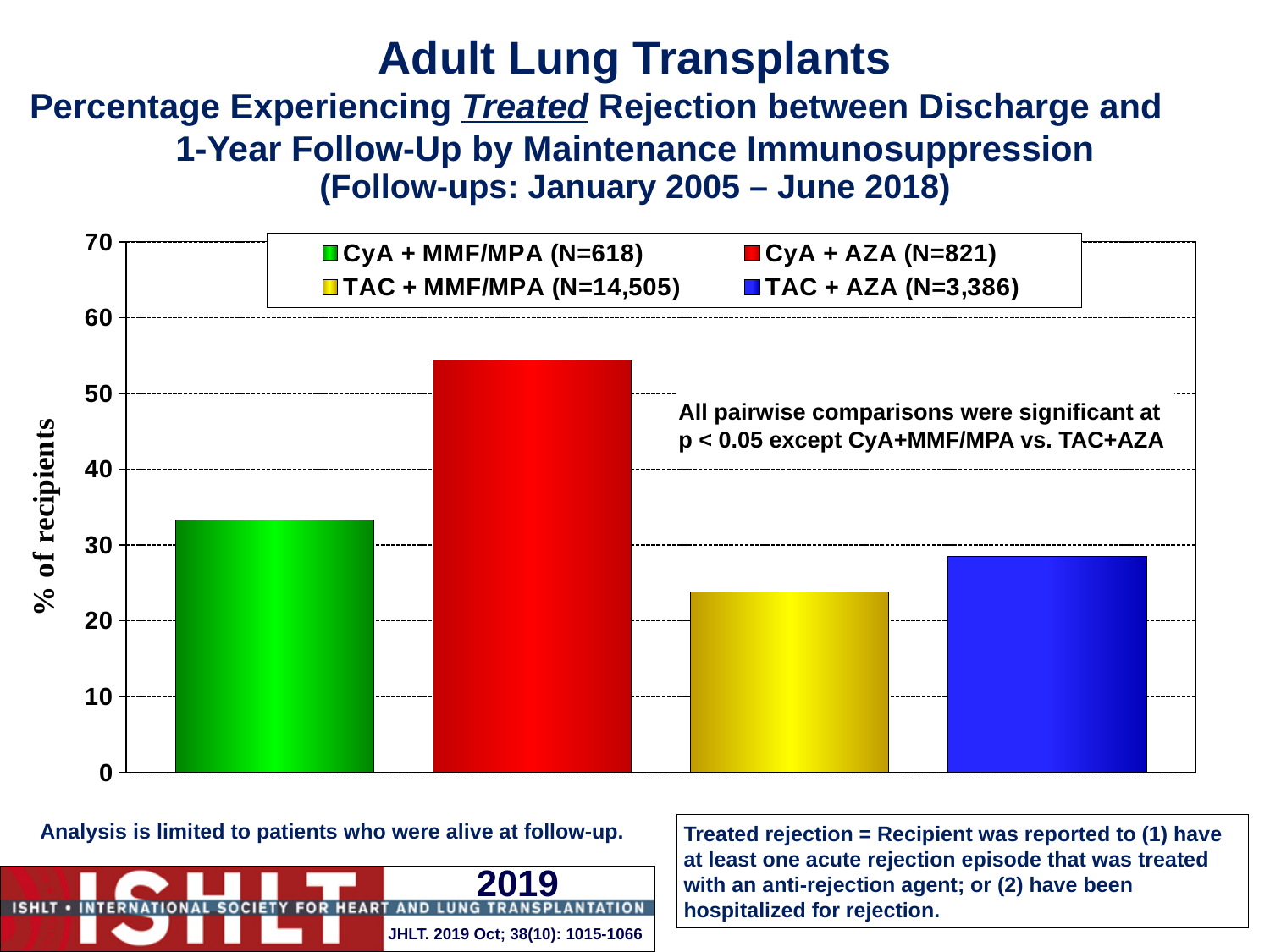
How many series does the legend list? 4 Which is larger, the value for CyA + MMF/MPA or the value for TAC + AZA? CyA + MMF/MPA Which immunosuppression group has the highest percentage of recipients experiencing treated rejection? CyA + AZA (N=821) Which immunosuppression group has the lowest percentage of recipients experiencing treated rejection? TAC + MMF/MPA (N=14,505) Is the value for CyA + AZA greater or less than 50? greater Is the value for TAC + MMF/MPA greater or less than 30? less What colour is the bar for TAC + MMF/MPA (N=14,505)? yellow How many bars are plotted in the chart? 4 What is the label of the y axis? % of recipients What kind of chart is shown on the slide? bar chart Is the value for CyA + MMF/MPA greater or less than 30? greater